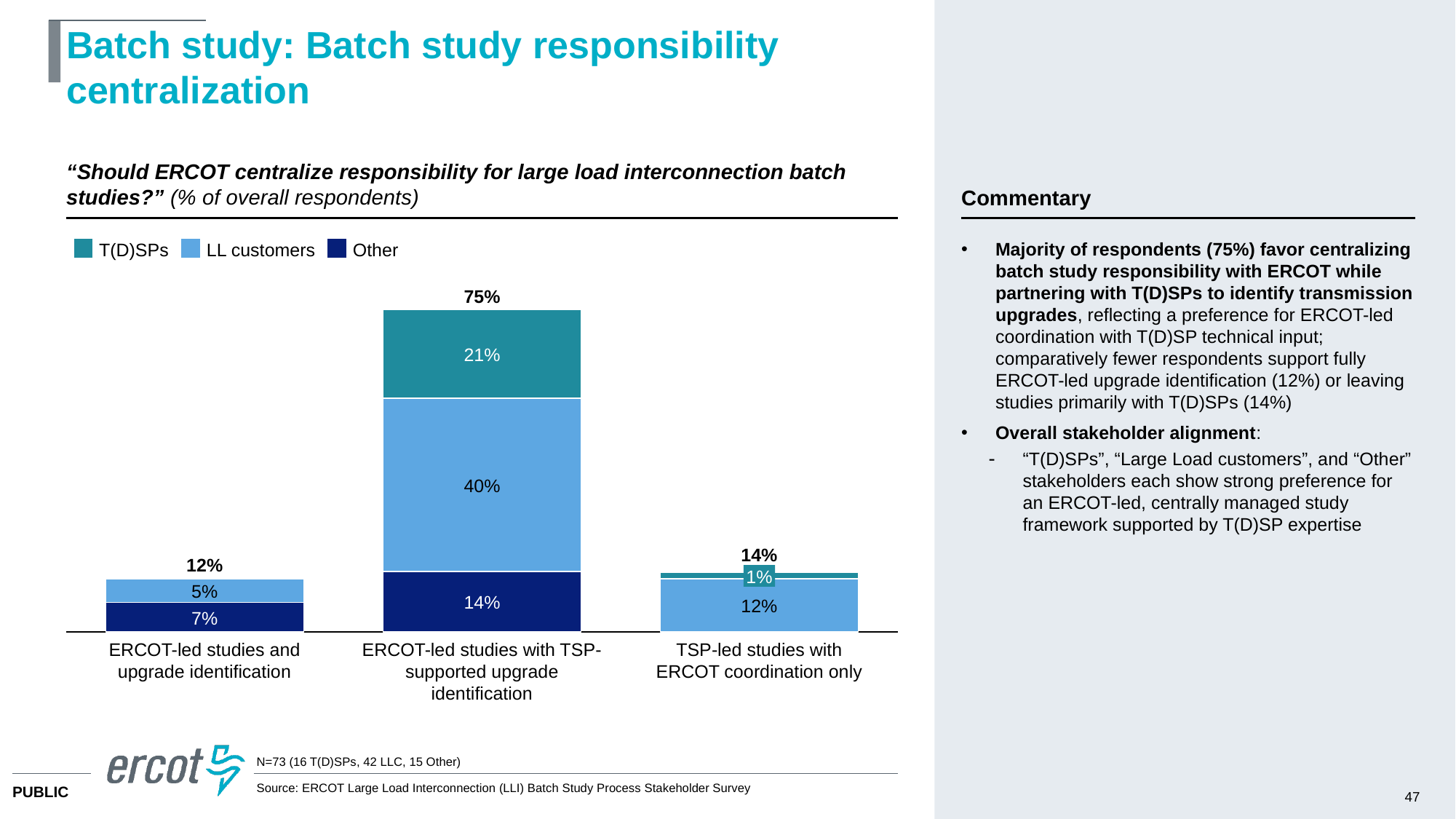
How many response options are shown on the x axis? 3 What is the T(D)SPs value for "TSP-led studies with ERCOT coordination only"? 1% Which option has the highest total share of respondents? ERCOT-led studies with TSP-supported upgrade identification What is the Other value for "ERCOT-led studies with TSP-supported upgrade identification"? 14% For "ERCOT-led studies and upgrade identification", which is larger: the Other segment or the LL customers segment? Other How many series does the legend list? 3 What kind of chart is shown on the slide? Stacked bar chart What is the difference in total share between "ERCOT-led studies with TSP-supported upgrade identification" and "ERCOT-led studies and upgrade identification"? 63 percentage points What is the total percentage of respondents for "TSP-led studies with ERCOT coordination only"? 14% Which option has the lowest total share of respondents? ERCOT-led studies and upgrade identification Which series is shown in dark navy blue in the legend? Other What percentage of LL customers chose "ERCOT-led studies with TSP-supported upgrade identification"? 40%